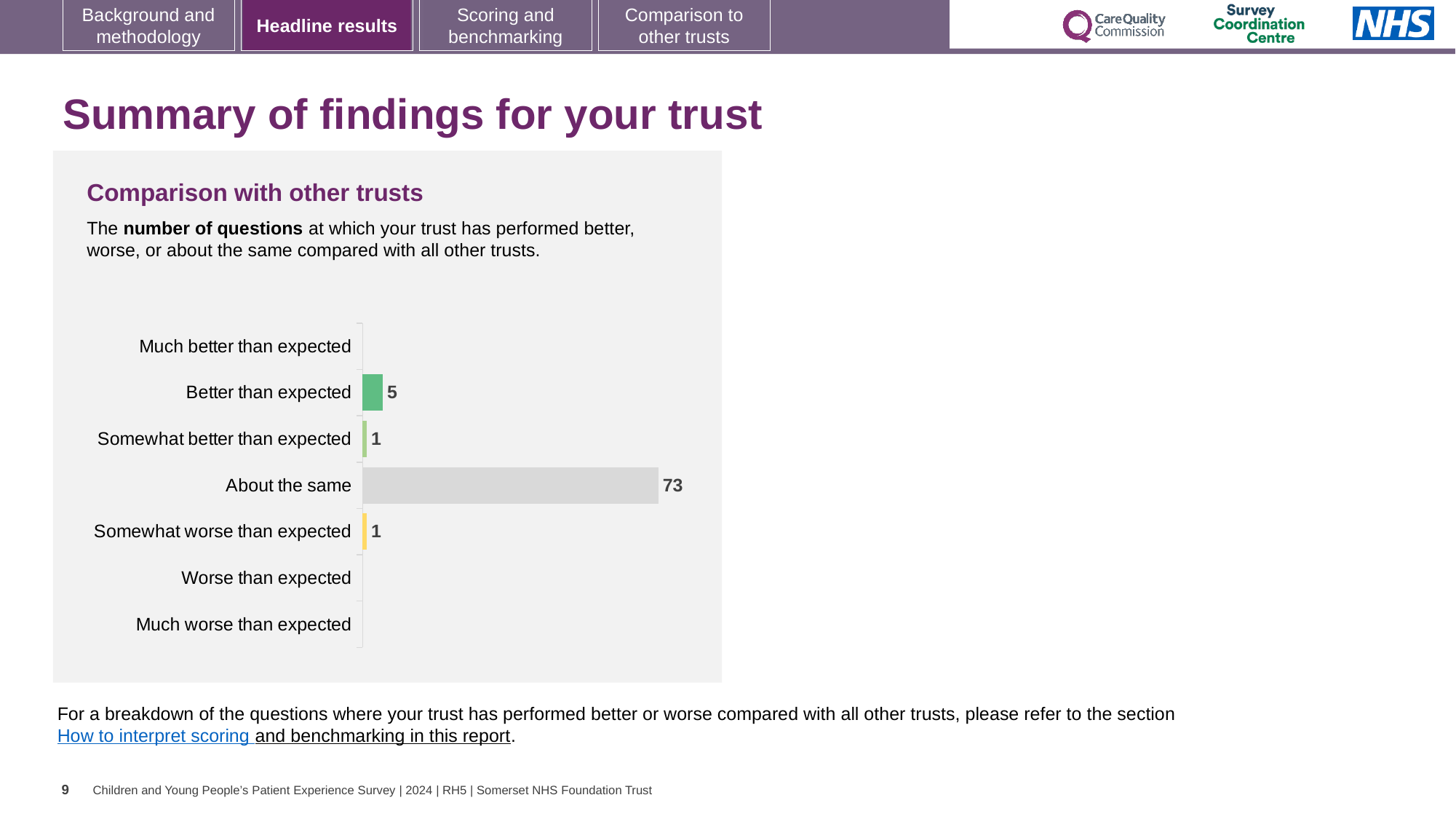
How many questions were rated 'Somewhat better than expected'? 1 How many questions were rated 'Somewhat worse than expected'? 1 How many questions were rated 'Better than expected'? 5 Which is larger: the number of questions rated 'Better than expected' or 'Somewhat better than expected'? Better than expected What is the difference between the number of questions rated 'About the same' and those rated 'Better than expected'? 68 What is the total number of questions rated better than expected across the 'Better than expected' and 'Somewhat better than expected' categories? 6 How many questions were rated 'About the same'? 73 How many categories are listed on the chart's axis? 7 What kind of chart is shown on the slide? Bar chart What colour is the bar for 'Somewhat worse than expected'? Yellow What is the title of the chart? Comparison with other trusts Which category has the highest number of questions? About the same